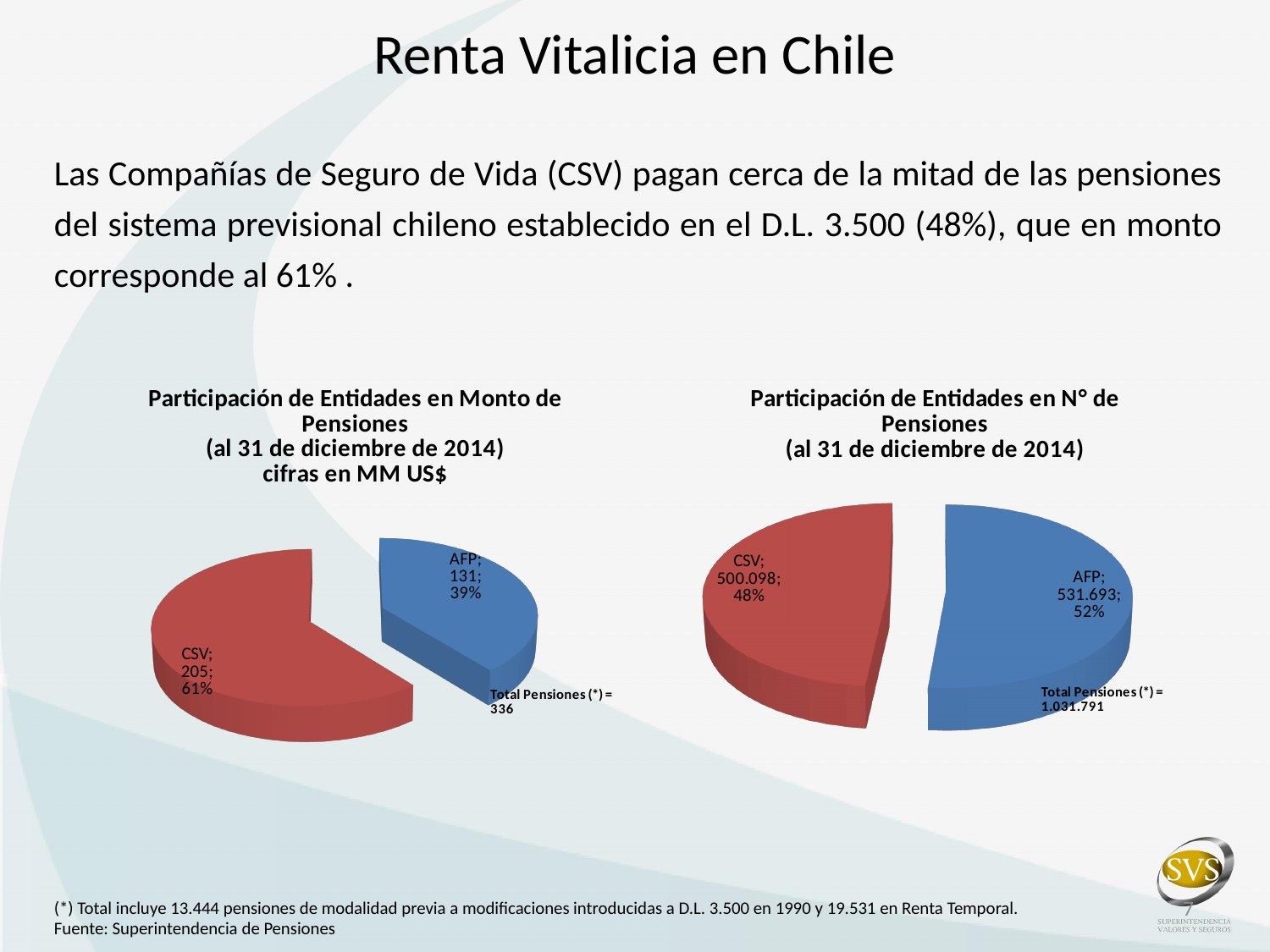
In the left chart (Participación de Entidades en Monto de Pensiones), which entity has the larger slice? CSV In the right chart (Participación de Entidades en N° de Pensiones), which entity has the smaller slice? CSV How many slices does the left chart (Participación de Entidades en Monto de Pensiones) have? 2 In the left chart (Participación de Entidades en Monto de Pensiones), what is the value for AFP? 131 What kind of chart is used on this slide? Pie chart In the right chart (Participación de Entidades en N° de Pensiones), what share of the pie does AFP hold? 52% In the left chart (Participación de Entidades en Monto de Pensiones), what is the value for CSV? 205 In the left chart (Participación de Entidades en Monto de Pensiones), what share of the pie does CSV hold? 61% What total is printed on the right chart (Participación de Entidades en N° de Pensiones)? 1.031.791 In the right chart (Participación de Entidades en N° de Pensiones), what is the value for AFP? 531.693 In the right chart (Participación de Entidades en N° de Pensiones), what is the value for CSV? 500.098 In the left chart (Participación de Entidades en Monto de Pensiones), what is the difference between the CSV and AFP values? 74